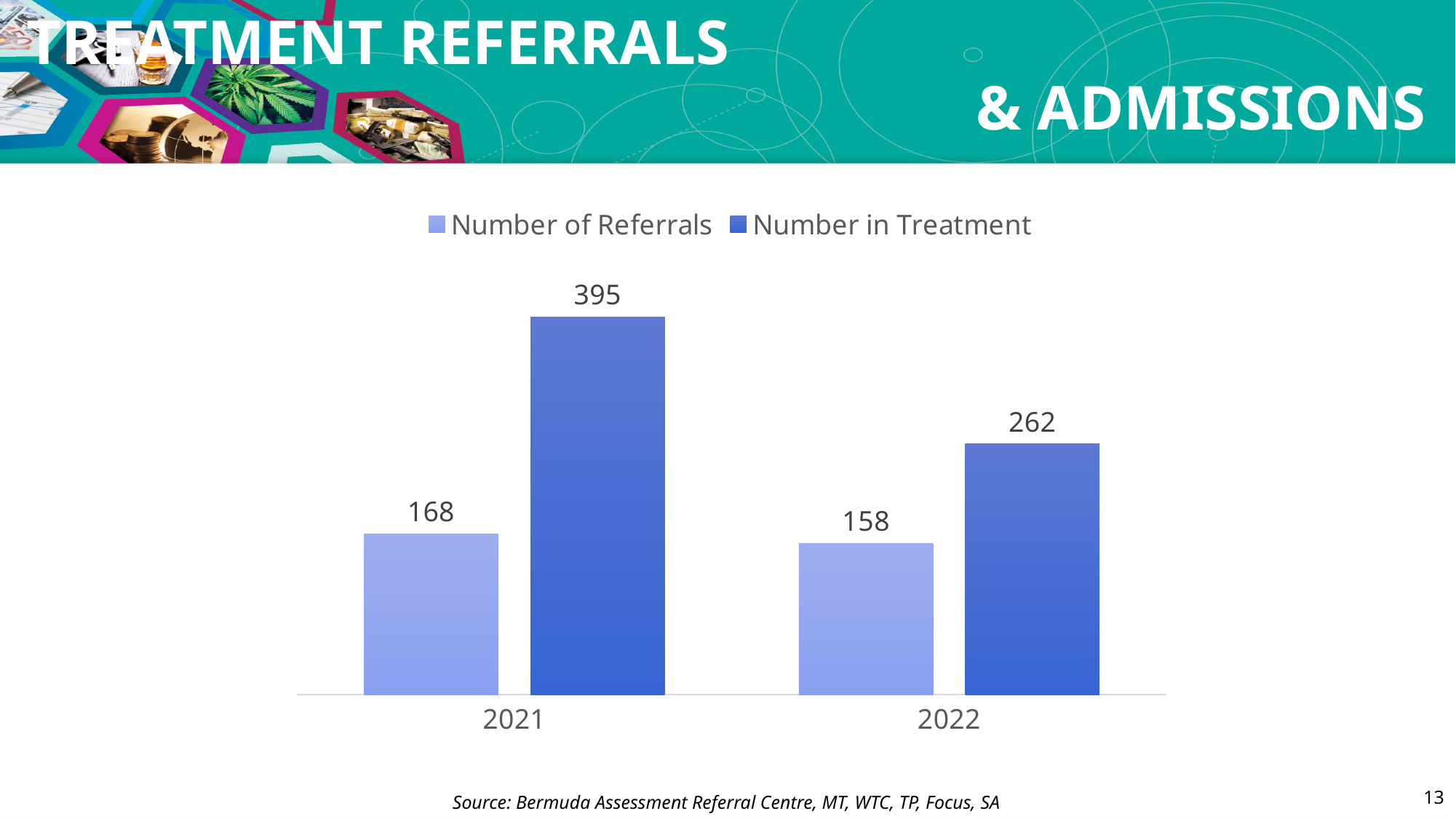
Which year has the lowest Number of Referrals? 2022 What kind of chart is shown on the slide? Bar chart What is the difference between the Number in Treatment and the Number of Referrals in 2022? 104 Which year has the highest Number in Treatment? 2021 What is the Number in Treatment for 2021? 395 How many years are shown on the x axis? 2 What is the Number of Referrals for 2022? 158 What is the difference between the Number in Treatment in 2021 and in 2022? 133 What is the Number in Treatment for 2022? 262 How many series does the legend list? 2 Which is larger in 2021, the Number of Referrals or the Number in Treatment? Number in Treatment What is the Number of Referrals for 2021? 168